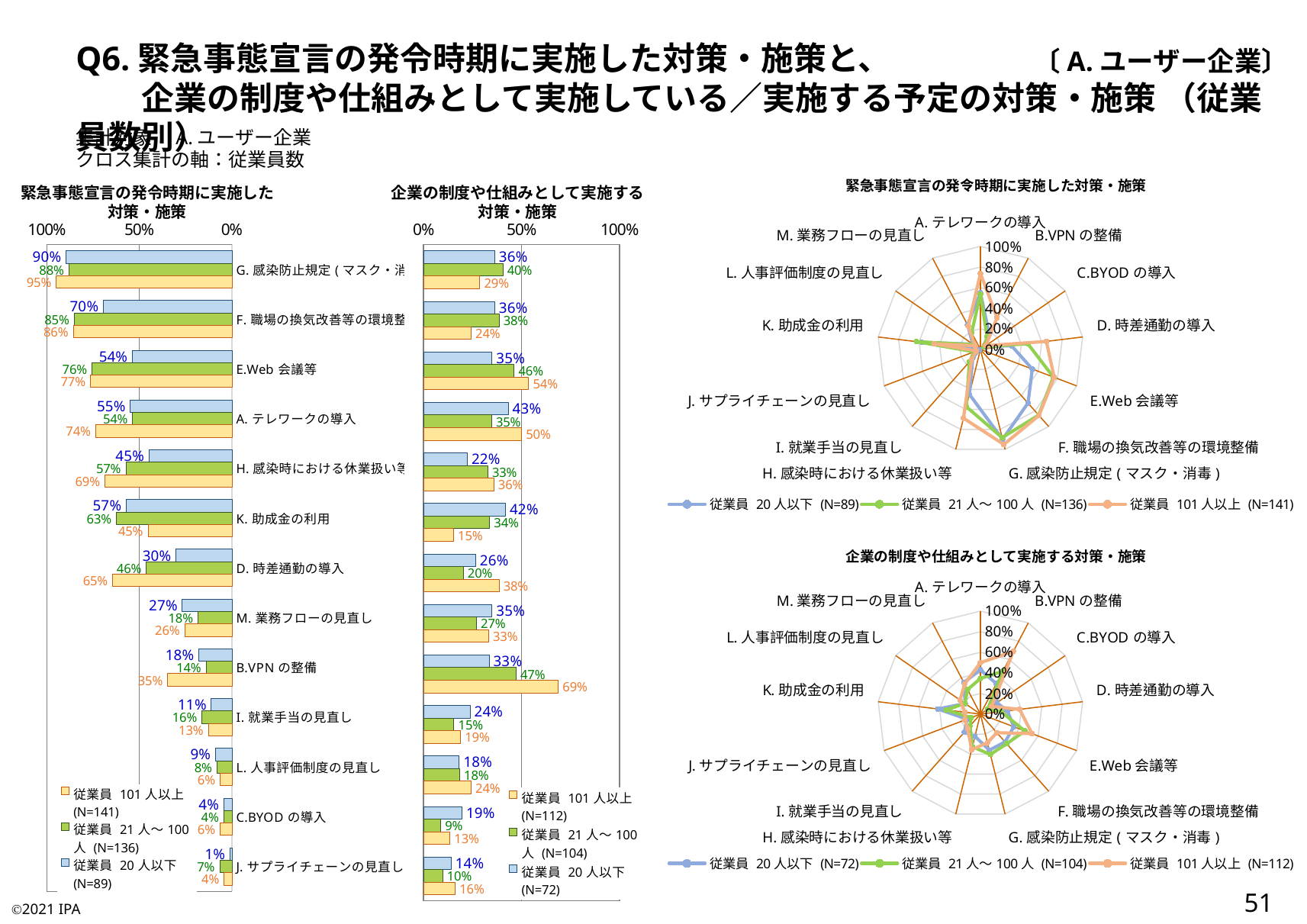
In the left bar chart titled 緊急事態宣言の発令時期に実施した対策・施策, which category has the highest value for 従業員 20人以下? G. 感染防止規定 In the middle bar chart titled 企業の制度や仕組みとして実施する対策・施策, what is the value for B.VPNの整備 for 従業員 101人以上? 69% In the middle bar chart titled 企業の制度や仕組みとして実施する対策・施策, what is the value for E.Web会議等 for 従業員 21人～100人? 46% In the middle bar chart titled 企業の制度や仕組みとして実施する対策・施策, which is larger for A. テレワークの導入: 従業員 20人以下 or 従業員 21人～100人? 従業員 20人以下 How many series does the legend of the lower radar chart titled 企業の制度や仕組みとして実施する対策・施策 list? 3 In the left bar chart titled 緊急事態宣言の発令時期に実施した対策・施策, what is the value for K. 助成金の利用 for 従業員 20人以下? 57% What kind of chart is the chart on the left of the slide titled 緊急事態宣言の発令時期に実施した対策・施策? Bar chart In the left bar chart titled 緊急事態宣言の発令時期に実施した対策・施策, which category has the lowest value for 従業員 20人以下? J. サプライチェーンの見直し In the left bar chart titled 緊急事態宣言の発令時期に実施した対策・施策, what is the value for G. 感染防止規定 for 従業員 101人以上? 95% In the left bar chart titled 緊急事態宣言の発令時期に実施した対策・施策, which is larger for D. 時差通勤の導入: 従業員 101人以上 or 従業員 20人以下? 従業員 101人以上 How many categories are plotted in the upper radar chart titled 緊急事態宣言の発令時期に実施した対策・施策? 13 In the middle bar chart titled 企業の制度や仕組みとして実施する対策・施策, what is the difference between 従業員 101人以上 and 従業員 20人以下 for K. 助成金の利用? 27%